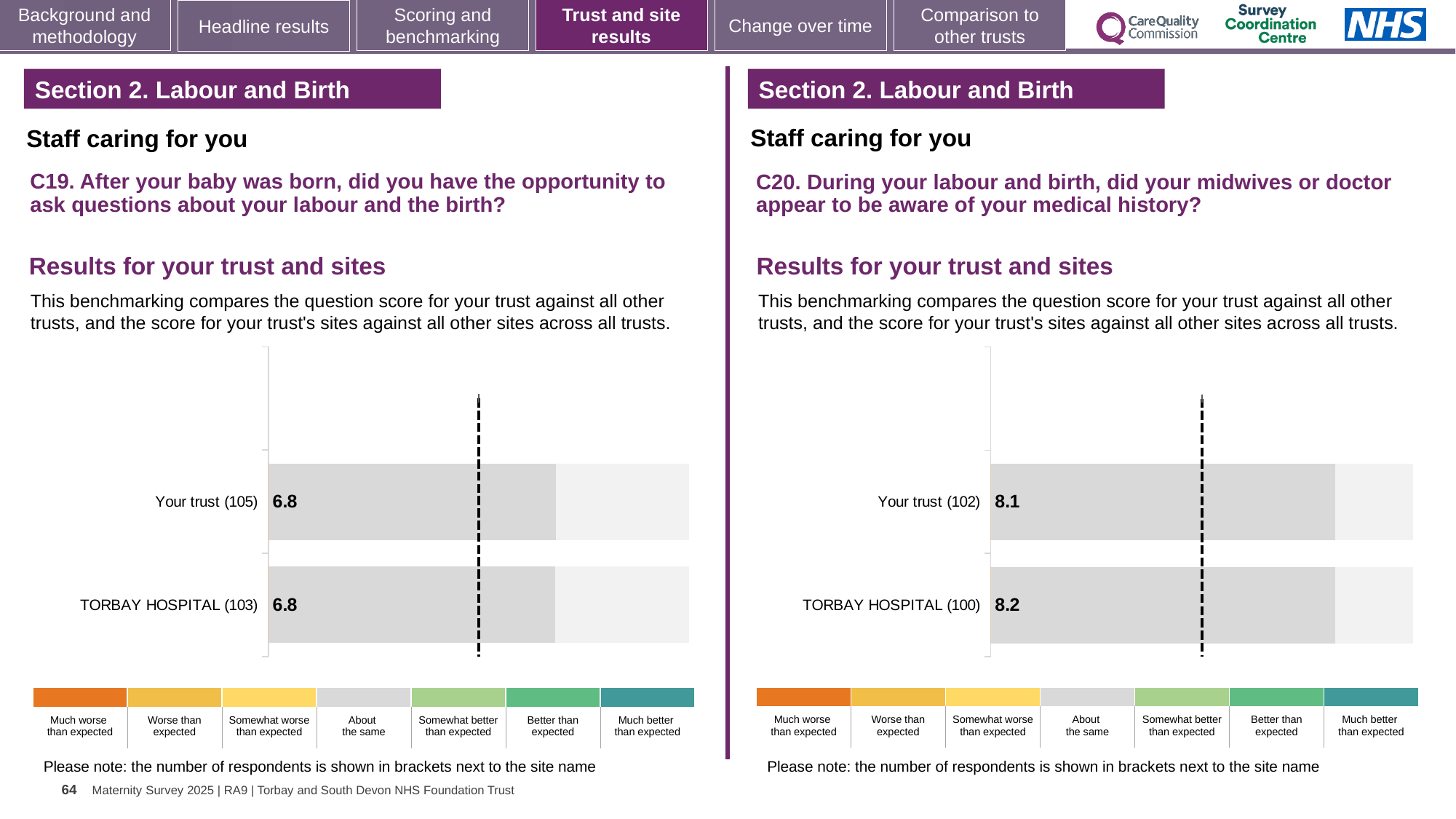
In the C19 chart on the left, what is the score for Your trust? 6.8 In the C19 chart on the left, what is the difference between the Your trust score and the TORBAY HOSPITAL score? 0 In the C20 chart on the right, which has the higher score, Your trust or TORBAY HOSPITAL? TORBAY HOSPITAL In the C20 chart on the right, what is the score for TORBAY HOSPITAL? 8.2 In the C19 chart on the left, how many respondents are shown in brackets for Your trust? 105 In the C20 chart on the right, what is the difference between the TORBAY HOSPITAL score and the Your trust score? 0.1 In the C20 chart on the right, how many respondents are shown in brackets for TORBAY HOSPITAL? 100 How many bars are plotted in the C19 chart on the left? 2 In the C20 chart on the right, what is the score for Your trust? 8.1 What type of chart is used for the C20 results on the right? Bar chart In the C19 chart on the left, what is the score for TORBAY HOSPITAL? 6.8